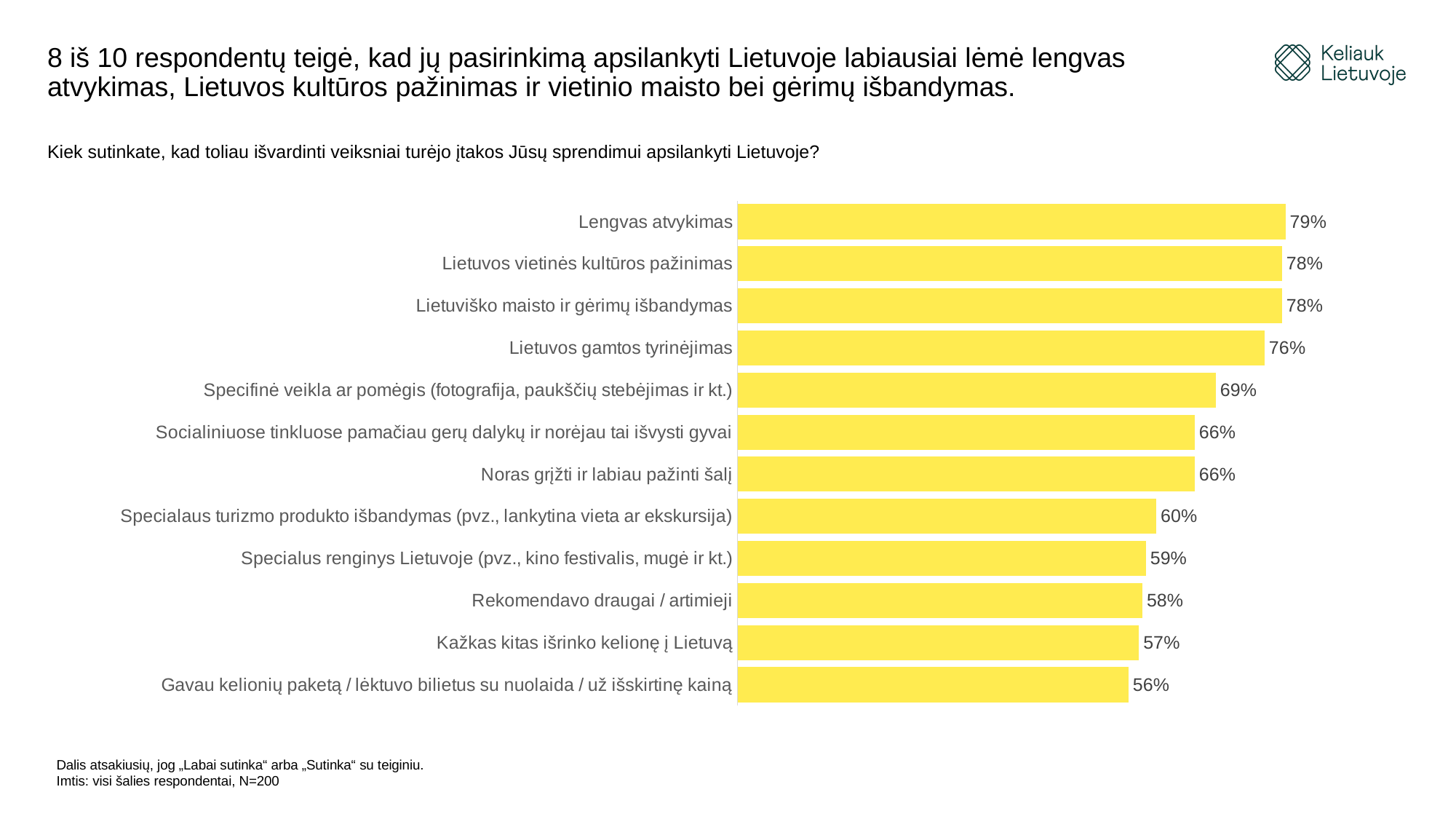
What is the difference between "Specifinė veikla ar pomėgis (fotografija, paukščių stebėjimas ir kt.)" and "Specialus renginys Lietuvoje (pvz., kino festivalis, mugė ir kt.)"? 10 percentage points What colour are the bars in the chart? Yellow Which has a higher value: "Lietuvos gamtos tyrinėjimas" or "Noras grįžti ir labiau pažinti šalį"? Lietuvos gamtos tyrinėjimas How many factors (bars) are shown in the chart? 12 What type of chart is shown on the slide? Bar chart Which factor has the highest share of agreement in the chart? Lengvas atvykimas What is the difference in percentage points between "Lengvas atvykimas" and "Gavau kelionių paketą / lėktuvo bilietus su nuolaida / už išskirtinę kainą"? 23 percentage points What is the value shown for "Rekomendavo draugai / artimieji"? 58% Which two factors share the same value of 78%? Lietuvos vietinės kultūros pažinimas and Lietuviško maisto ir gėrimų išbandymas Which factor has the lowest share of agreement in the chart? Gavau kelionių paketą / lėktuvo bilietus su nuolaida / už išskirtinę kainą What percentage of respondents agreed that "Lengvas atvykimas" influenced their decision to visit Lithuania? 79% What is the value shown for "Lietuvos gamtos tyrinėjimas"? 76%